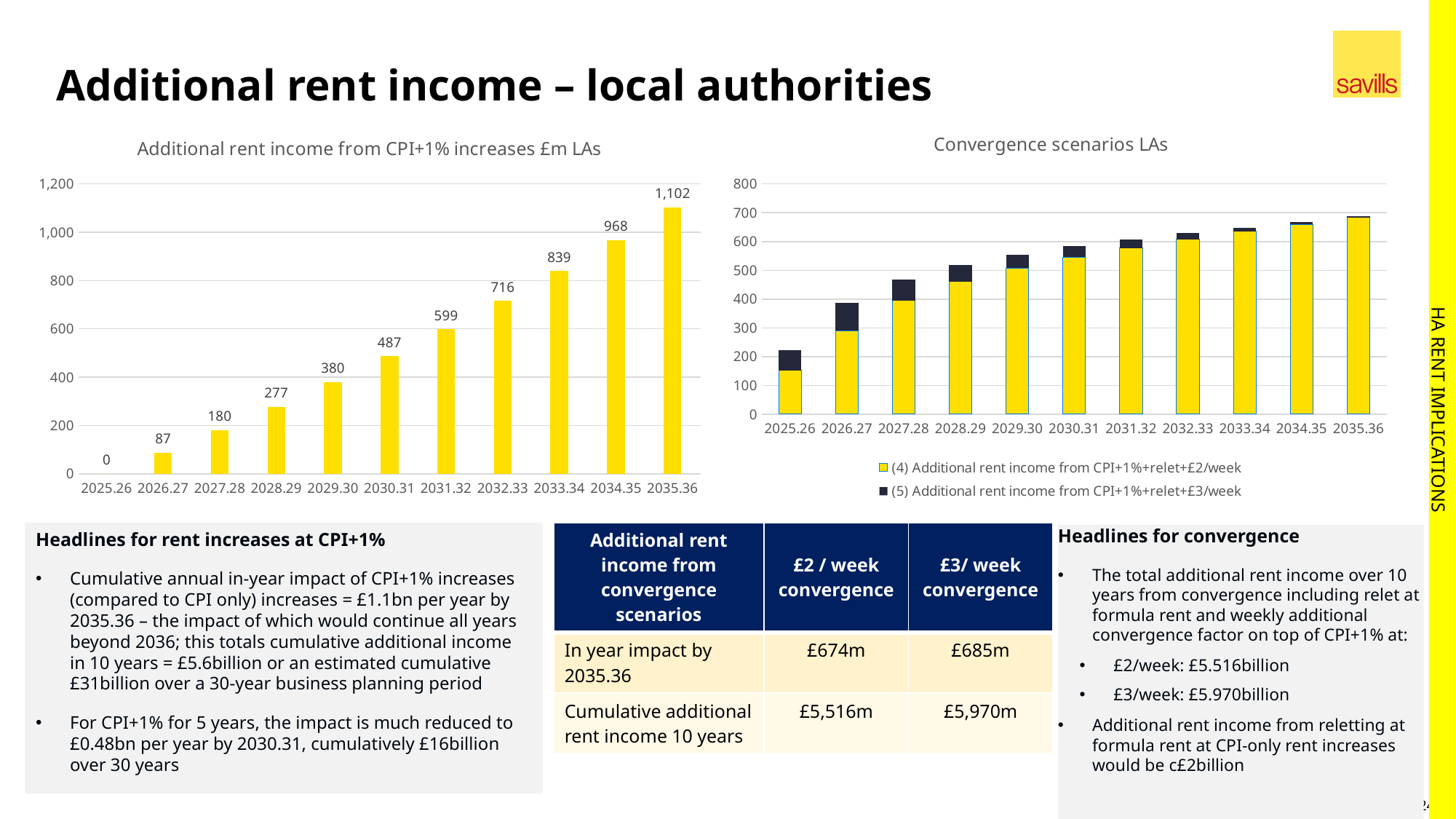
In the chart titled 'Additional rent income from CPI+1% increases £m LAs', what is the difference between the values for 2034.35 and 2033.34? 129 In the chart titled 'Additional rent income from CPI+1% increases £m LAs', which year has the lowest value? 2025.26 In the chart titled 'Additional rent income from CPI+1% increases £m LAs', which year has the highest value? 2035.36 What kind of chart is the chart titled 'Convergence scenarios LAs'? stacked bar chart How many series does the legend of the chart titled 'Convergence scenarios LAs' list? 2 In the chart titled 'Convergence scenarios LAs', is the total stacked value for 2025.26 greater or less than 300? less In the chart titled 'Additional rent income from CPI+1% increases £m LAs', what is the value for 2027.28? 180 In the chart titled 'Additional rent income from CPI+1% increases £m LAs', how many years are shown on the x axis? 11 In the chart titled 'Convergence scenarios LAs', which colour represents the series '(5) Additional rent income from CPI+1%+relet+£3/week'? dark navy In the chart titled 'Additional rent income from CPI+1% increases £m LAs', what is the value for 2035.36? 1,102 In the chart titled 'Additional rent income from CPI+1% increases £m LAs', do the values rise or fall from 2025.26 to 2035.36? rise In the chart titled 'Additional rent income from CPI+1% increases £m LAs', what is the value for 2030.31? 487